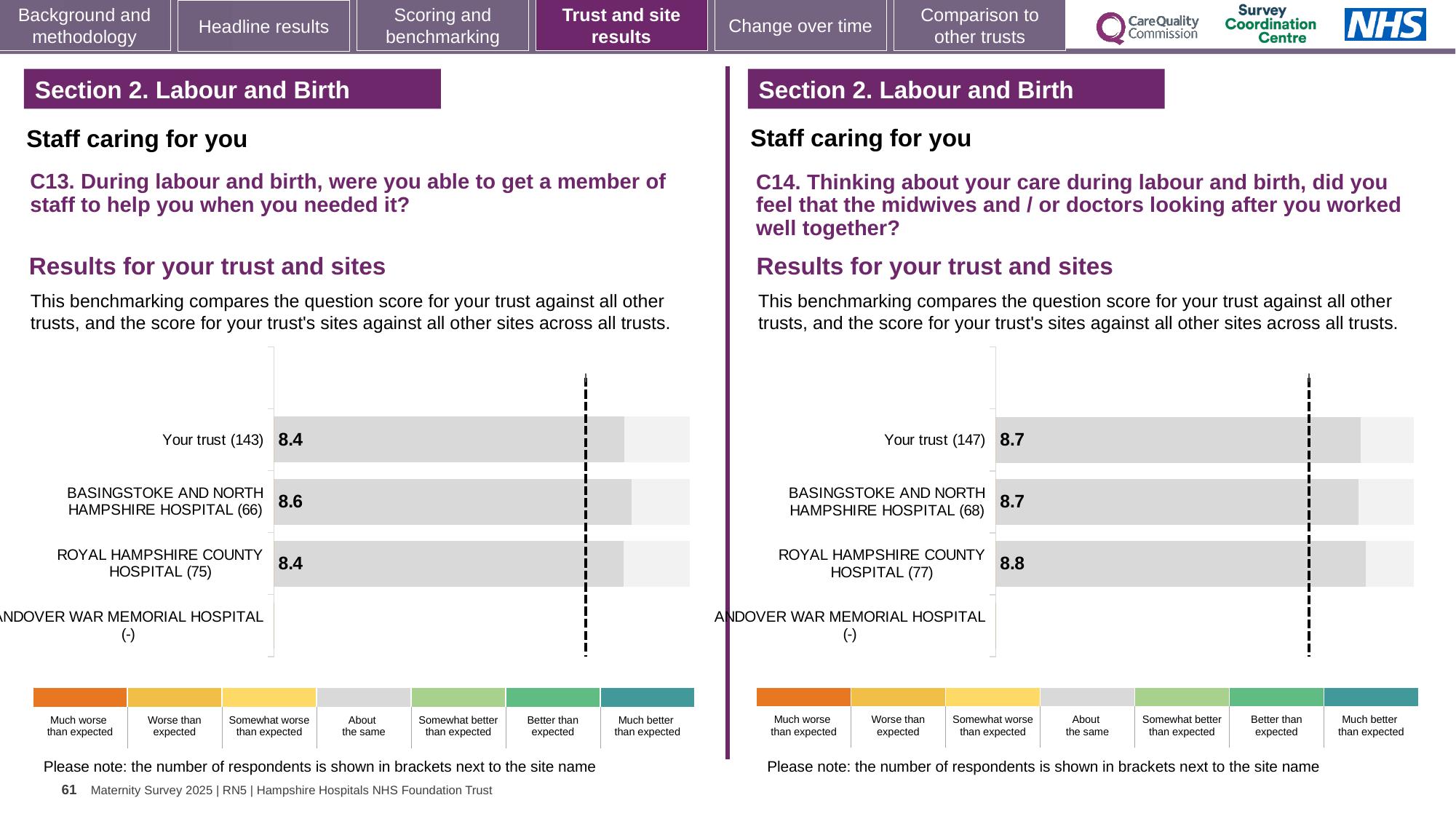
On the C13 chart (left), what is the score for Basingstoke and North Hampshire Hospital? 8.6 On the C14 chart (right), what is the score for Your trust? 8.7 What kind of chart is used on the C13 chart (left)? Bar chart On the C13 chart (left), what is the difference between the scores for Basingstoke and North Hampshire Hospital and Royal Hampshire County Hospital? 0.2 On the C14 chart (right), how many respondents are shown for Basingstoke and North Hampshire Hospital? 68 On the C13 chart (left), which site has the highest score? Basingstoke and North Hampshire Hospital On the C14 chart (right), which site has the highest score? Royal Hampshire County Hospital On the C13 chart (left), how many respondents are shown for Your trust? 143 On the C14 chart (right), how many rows (sites including Your trust) are listed? 4 On the C14 chart (right), what is the score for Royal Hampshire County Hospital? 8.8 Which is larger: the Your trust score on the C13 chart or the Your trust score on the C14 chart? C14 chart On the C13 chart (left), what is the score for Your trust? 8.4